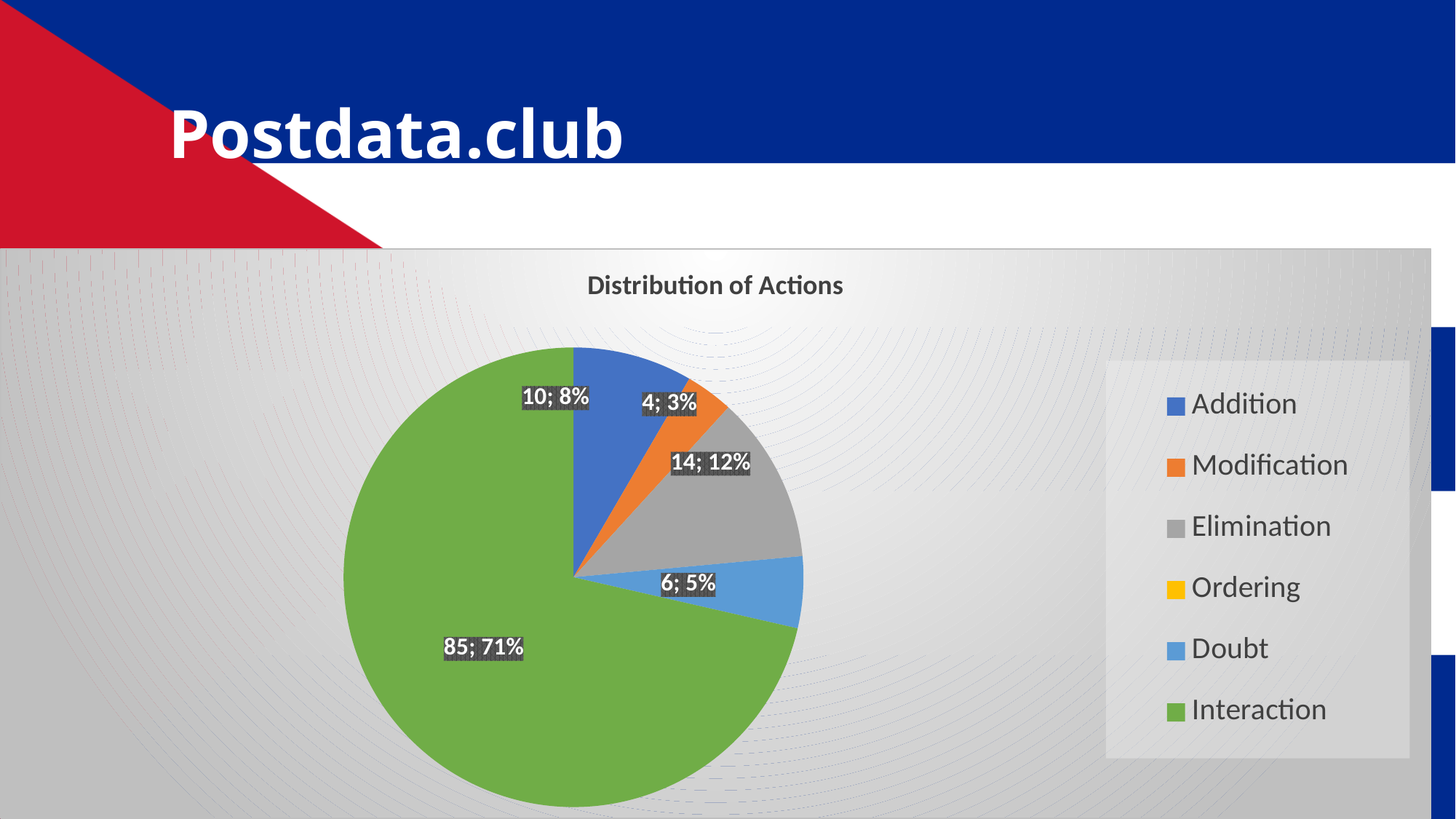
What share of the pie does Elimination represent? 12% Of the slices with data labels, which category has the smallest slice? Modification What is the count shown for Interaction? 85 Which category has the largest slice of the pie? Interaction What is the count shown for Modification? 4 What share of the pie does Interaction represent? 71% How many entries does the chart's legend list? 6 What share of the pie does Doubt represent? 5% What is the difference in count between Interaction and Elimination? 71 What kind of chart is shown on the slide? pie chart What is the title of the chart? Distribution of Actions What is the count shown for Elimination? 14